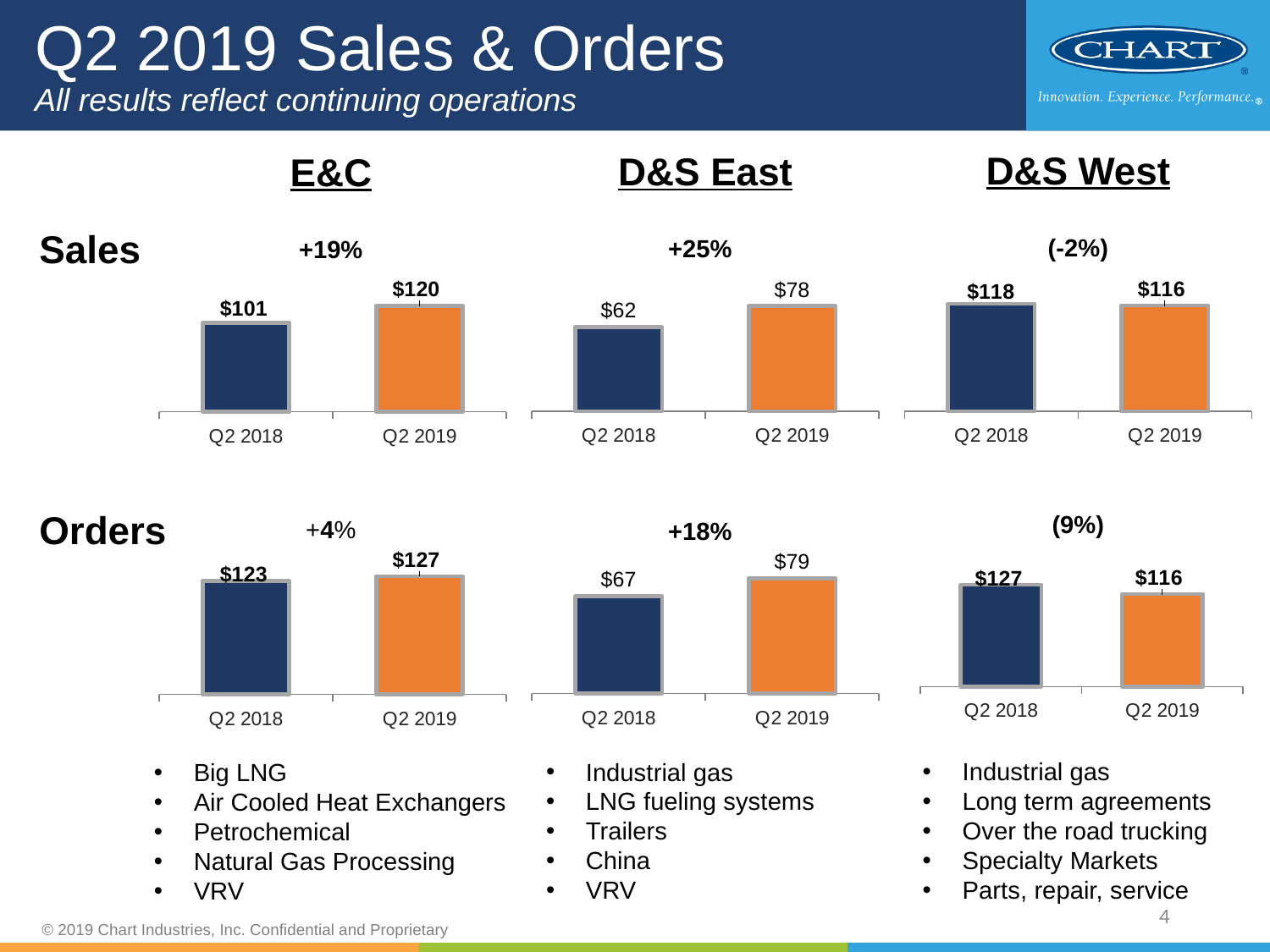
In the D&S East Orders chart, which period has the highest value? Q2 2019 In the E&C Sales chart, what is the difference between the Q2 2019 and Q2 2018 values? $19 How many bars are shown in the D&S East Sales chart? 2 In the D&S West Orders chart, what is the value for Q2 2019? $116 In the D&S West Sales chart, do the values rise or fall from Q2 2018 to Q2 2019? Fall In the E&C Sales chart, what is the value for Q2 2019? $120 What type of chart is used for the E&C Orders data? Bar chart In the D&S East Sales chart, what is the value for Q2 2018? $62 In the D&S East Orders chart, what is the value for Q2 2019? $79 In the D&S West Orders chart, what is the difference between the Q2 2018 and Q2 2019 values? $11 In the D&S West Sales chart, which period has the higher value, Q2 2018 or Q2 2019? Q2 2018 In the E&C Orders chart, which period has the lowest value? Q2 2018